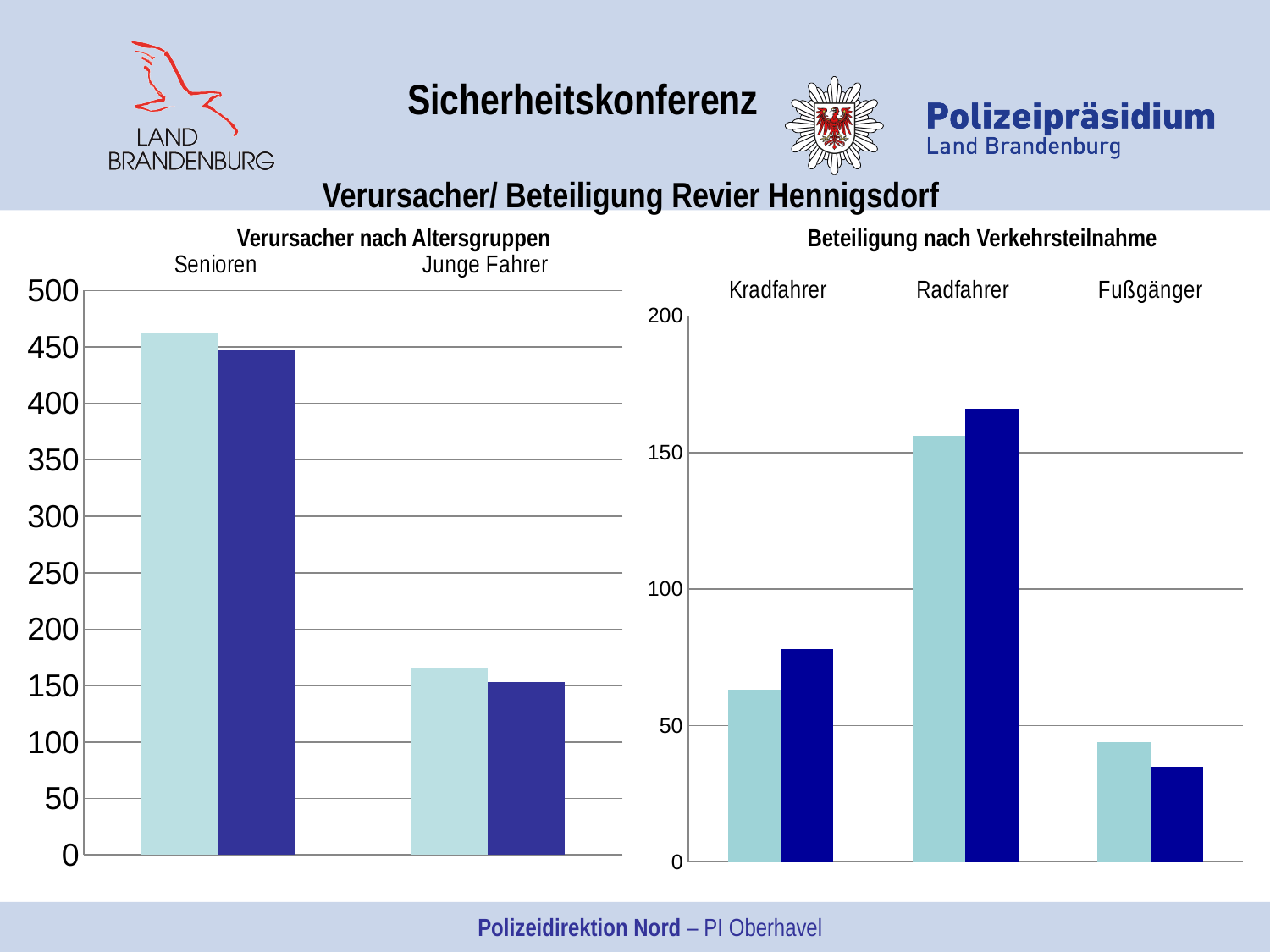
In the right chart, 'Beteiligung nach Verkehrsteilnahme', is the value of the dark blue bar for Radfahrer greater or less than 150? greater How many categories are shown on the x axis of the left chart, 'Verursacher nach Altersgruppen'? 2 What is the title of the right chart on the slide? Beteiligung nach Verkehrsteilnahme In the left chart, 'Verursacher nach Altersgruppen', is the value of the light blue bar for Senioren greater or less than 400? greater How many categories are shown on the x axis of the right chart, 'Beteiligung nach Verkehrsteilnahme'? 3 What kind of chart is the left chart, 'Verursacher nach Altersgruppen'? bar chart In the left chart, 'Verursacher nach Altersgruppen', which category has the highest bars? Senioren In the right chart, 'Beteiligung nach Verkehrsteilnahme', which category has the lowest bars? Fußgänger In the right chart, 'Beteiligung nach Verkehrsteilnahme', which category has the highest bars? Radfahrer In the left chart, 'Verursacher nach Altersgruppen', is the value of the light blue bar for Junge Fahrer greater or less than 200? less In the right chart, 'Beteiligung nach Verkehrsteilnahme', which has the larger light blue bar, Kradfahrer or Fußgänger? Kradfahrer